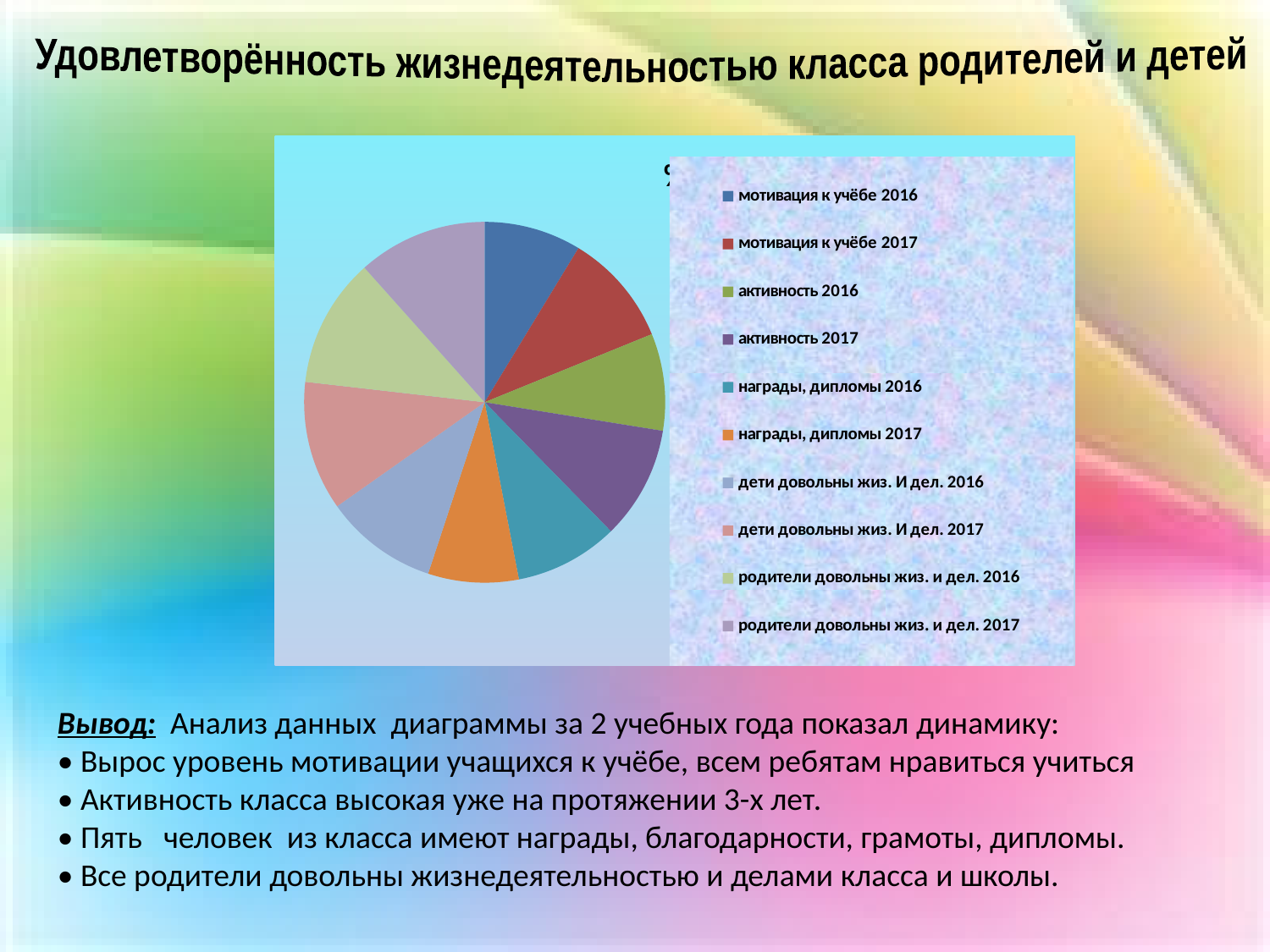
Which legend entry is listed first in the pie chart's legend? мотивация к учёбе 2016 What kind of chart is shown on the slide? pie chart Which slice is larger in the pie chart: 'родители довольны жиз. и дел. 2016' or 'активность 2016'? родители довольны жиз. и дел. 2016 How many entries does the legend of the pie chart list? 10 How many slices does the pie chart have? 10 How many legend entries in the pie chart refer to the year 2017? 5 Which colour represents 'мотивация к учёбе 2016' in the pie chart? blue